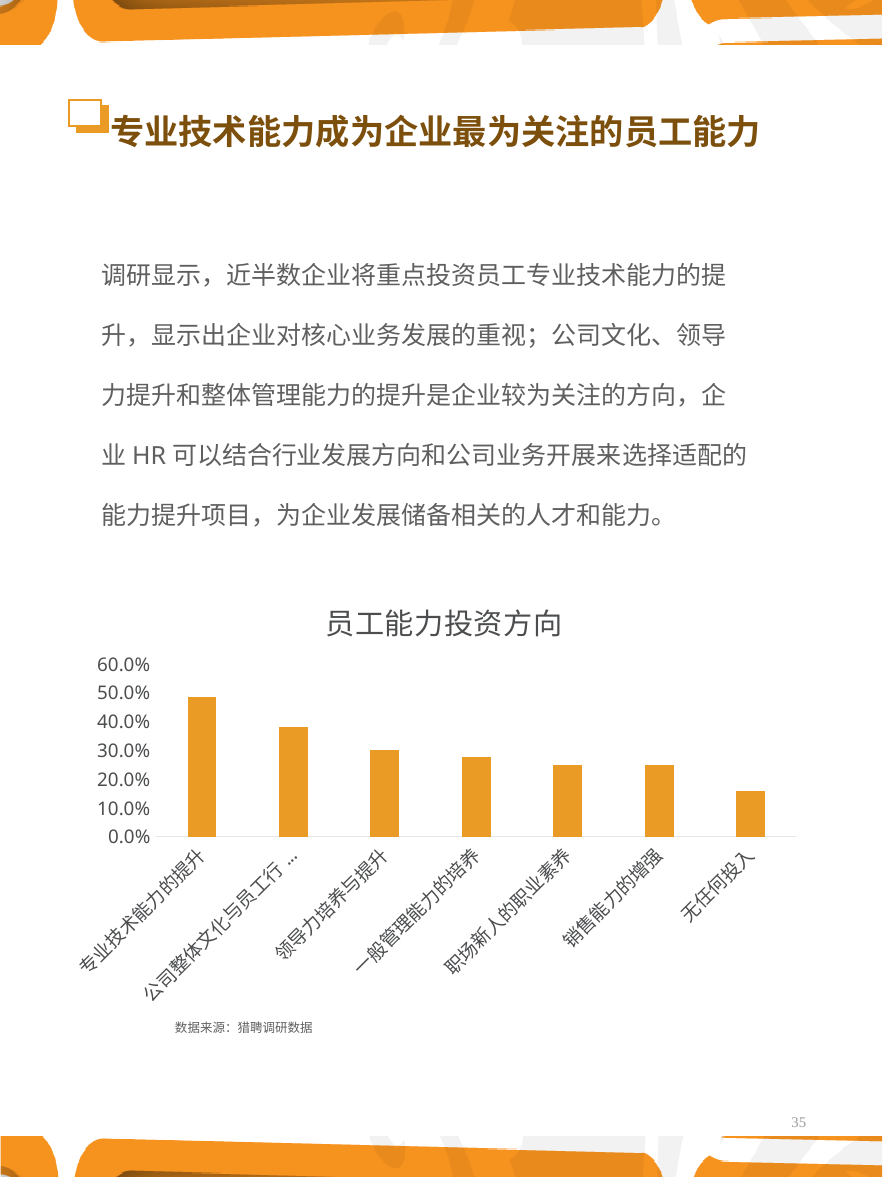
Is the value for 销售能力的增强 greater or less than 30.0%? less Is the value for 领导力培养与提升 greater or less than 20.0%? greater How many categories are shown on the x axis of the chart? 7 Is the value for 专业技术能力的提升 greater or less than 40.0%? greater What type of chart is shown on the slide? bar chart What data source is cited below the chart? 猎聘调研数据 Do the values generally rise or fall from left to right along the x axis? fall What is the title of the chart? 员工能力投资方向 Which category has the highest value in the chart? 专业技术能力的提升 Which is larger, the value for 专业技术能力的提升 or the value for 领导力培养与提升? 专业技术能力的提升 Which category has the lowest value in the chart? 无任何投入